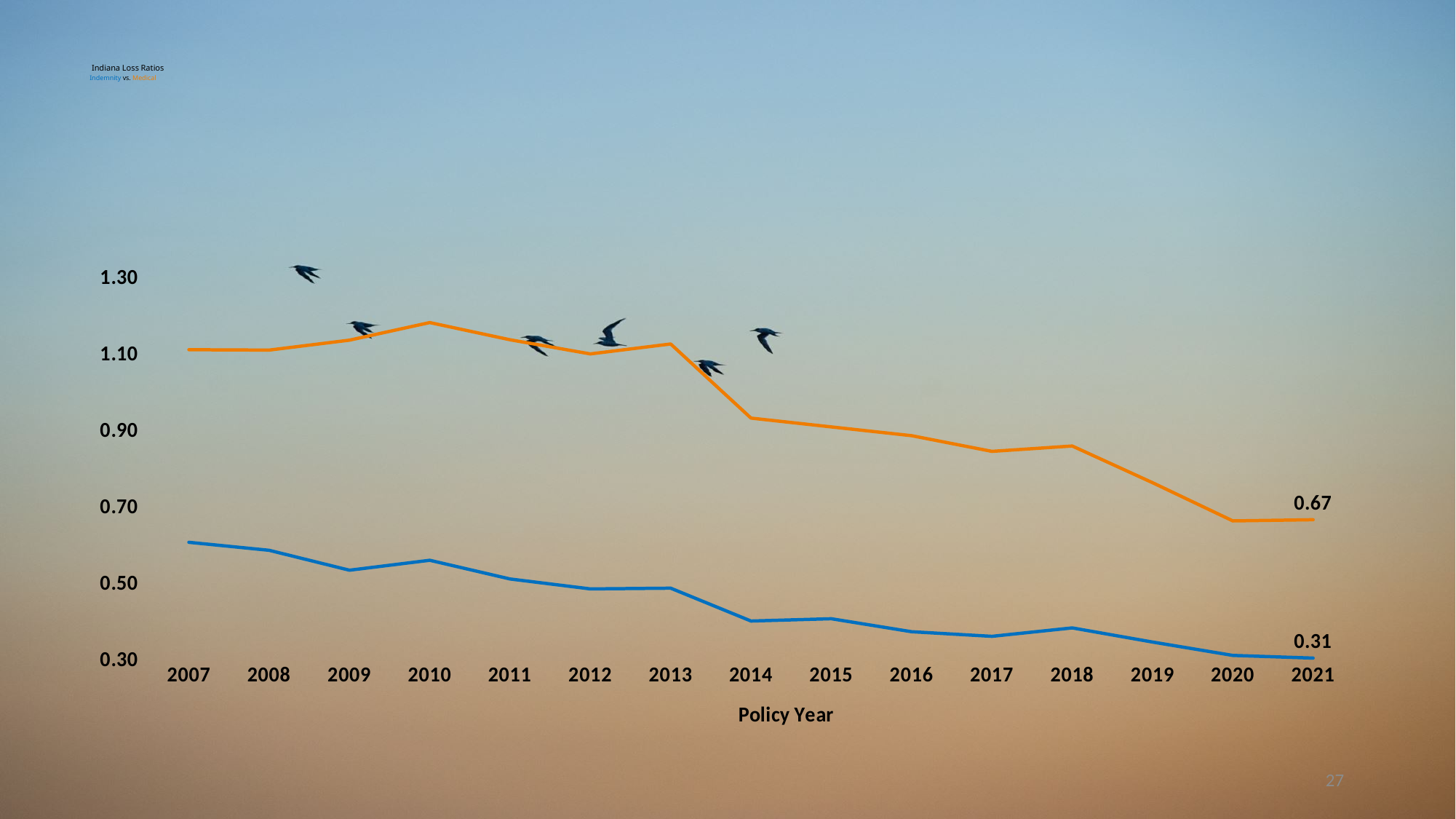
What is the title of the x axis? Policy Year How many series does the chart show? 2 In which policy year is the Medical loss ratio highest? 2010 Is the Indemnity loss ratio for 2007 greater or less than 0.70? less What is the difference between the Medical and Indemnity loss ratios in 2021? 0.36 In 2021, which is larger, the Medical loss ratio or the Indemnity loss ratio? Medical Does the Medical loss ratio rise or fall overall from 2007 to 2021? Fall How many policy years are plotted on the x axis? 15 What is the Indemnity loss ratio for policy year 2021? 0.31 Is the Medical loss ratio for 2010 greater or less than 1.10? greater What is the Medical loss ratio for policy year 2021? 0.67 What kind of chart is shown on the slide? Line chart